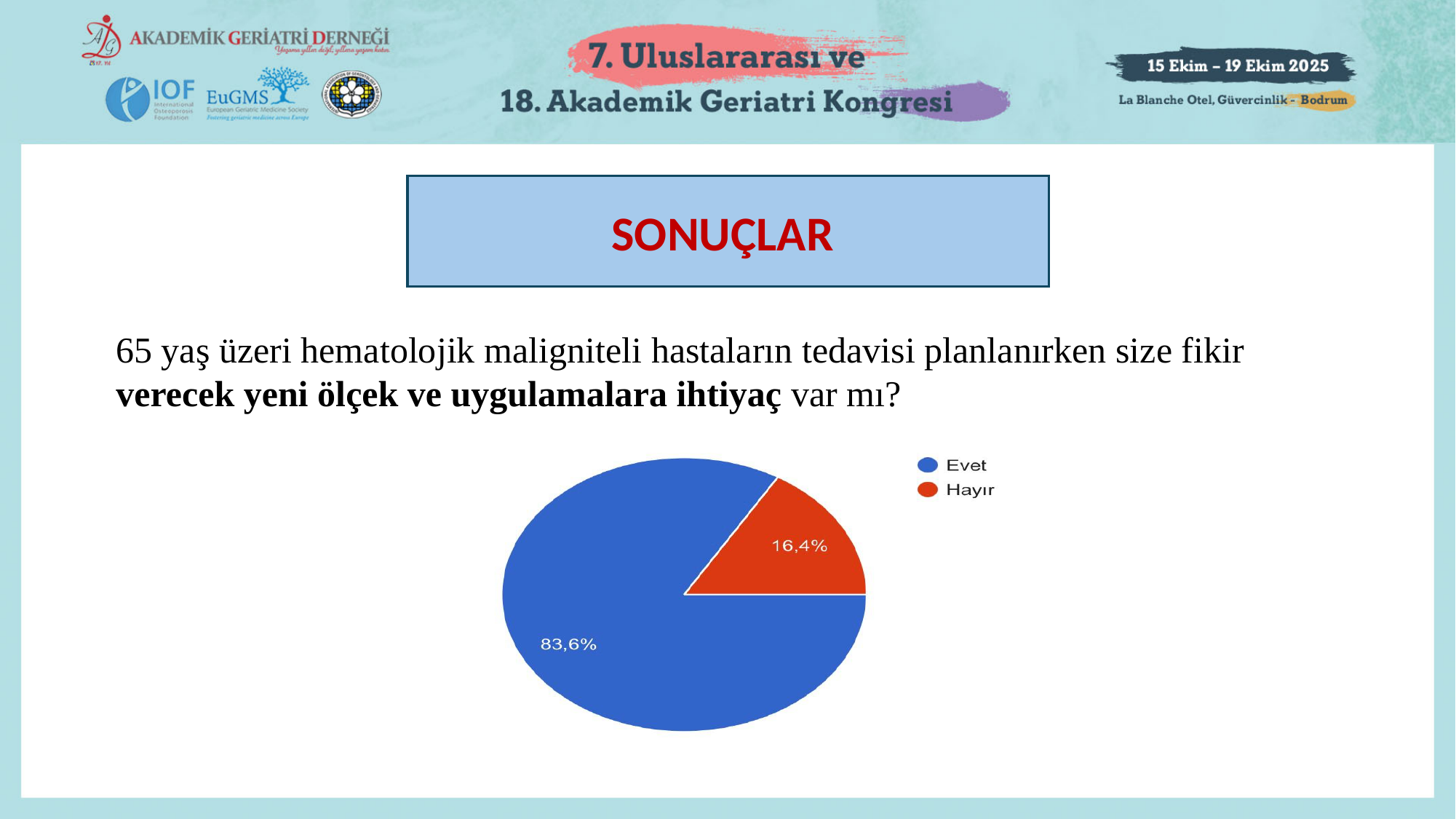
What colour is the Hayır slice in the pie chart? red Which slice of the pie is the largest? Evet What colour is the Evet slice in the pie chart? blue Which slice of the pie is the smallest? Hayır What share of the pie does the Hayır slice represent? 16,4% Which is larger, the Evet slice or the Hayır slice? Evet How many slices does the pie chart have? 2 What is the difference in percentage points between the Evet and Hayır slices? 67,2 What share of the pie does the Evet slice represent? 83,6% What kind of chart is shown on the slide? pie chart How many entries does the legend list? 2